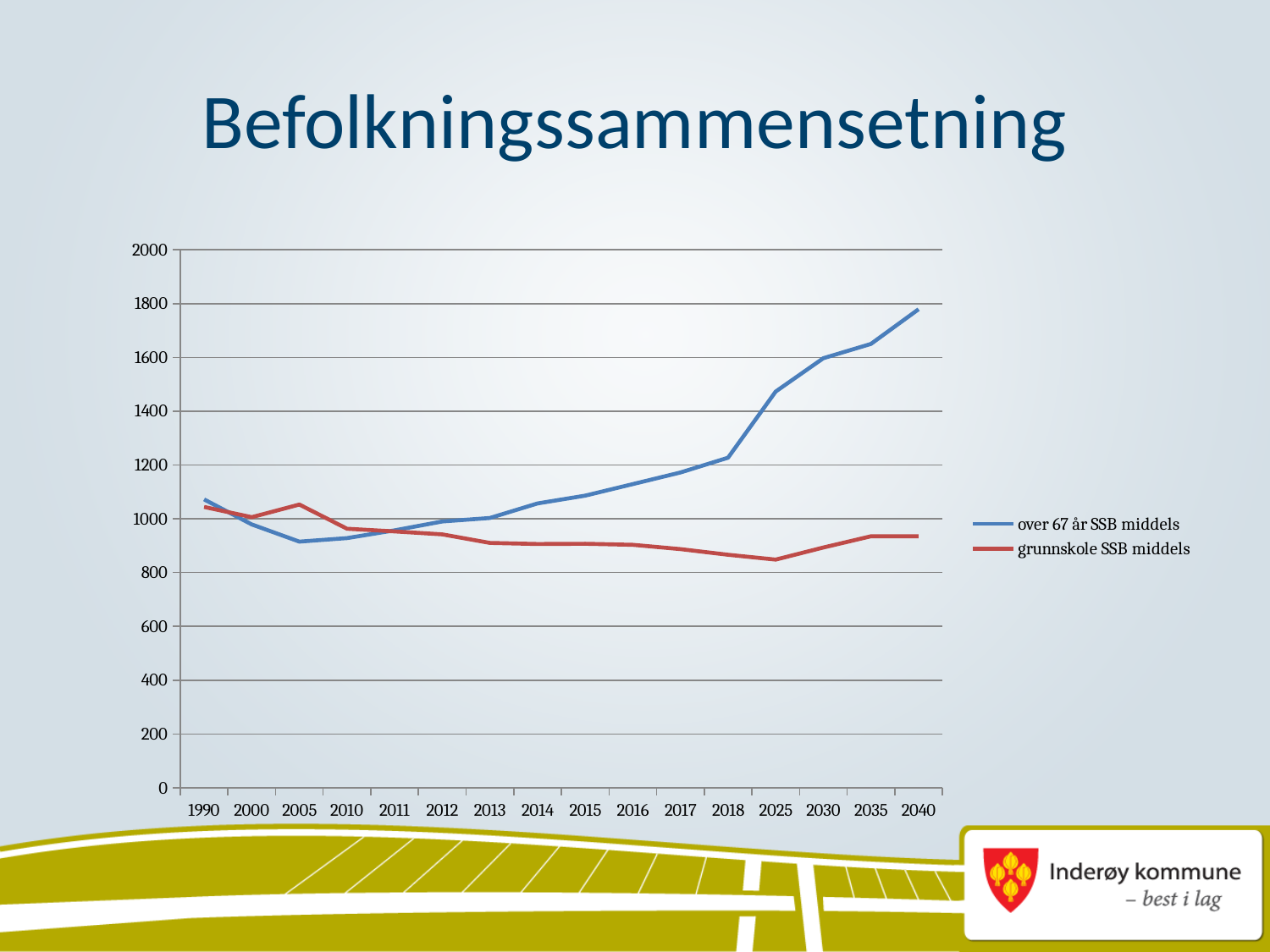
How many series does the legend list? 2 Is the value for 'over 67 år SSB middels' in 2040 greater or less than 1600? greater What is the title of the slide containing the chart? Befolkningssammensetning In which year does the 'over 67 år SSB middels' series reach its highest value? 2040 What kind of chart is shown on the slide? line chart In which year does the 'over 67 år SSB middels' series reach its lowest value? 2005 Is the value for 'grunnskole SSB middels' in 2025 greater or less than 1000? less Which series is drawn in red? grunnskole SSB middels Does the 'over 67 år SSB middels' series rise or fall from 2005 to 2040? rise In which year does the 'grunnskole SSB middels' series reach its lowest value? 2025 How many years are shown on the x axis? 16 In 2005, which series has the larger value, 'over 67 år SSB middels' or 'grunnskole SSB middels'? grunnskole SSB middels